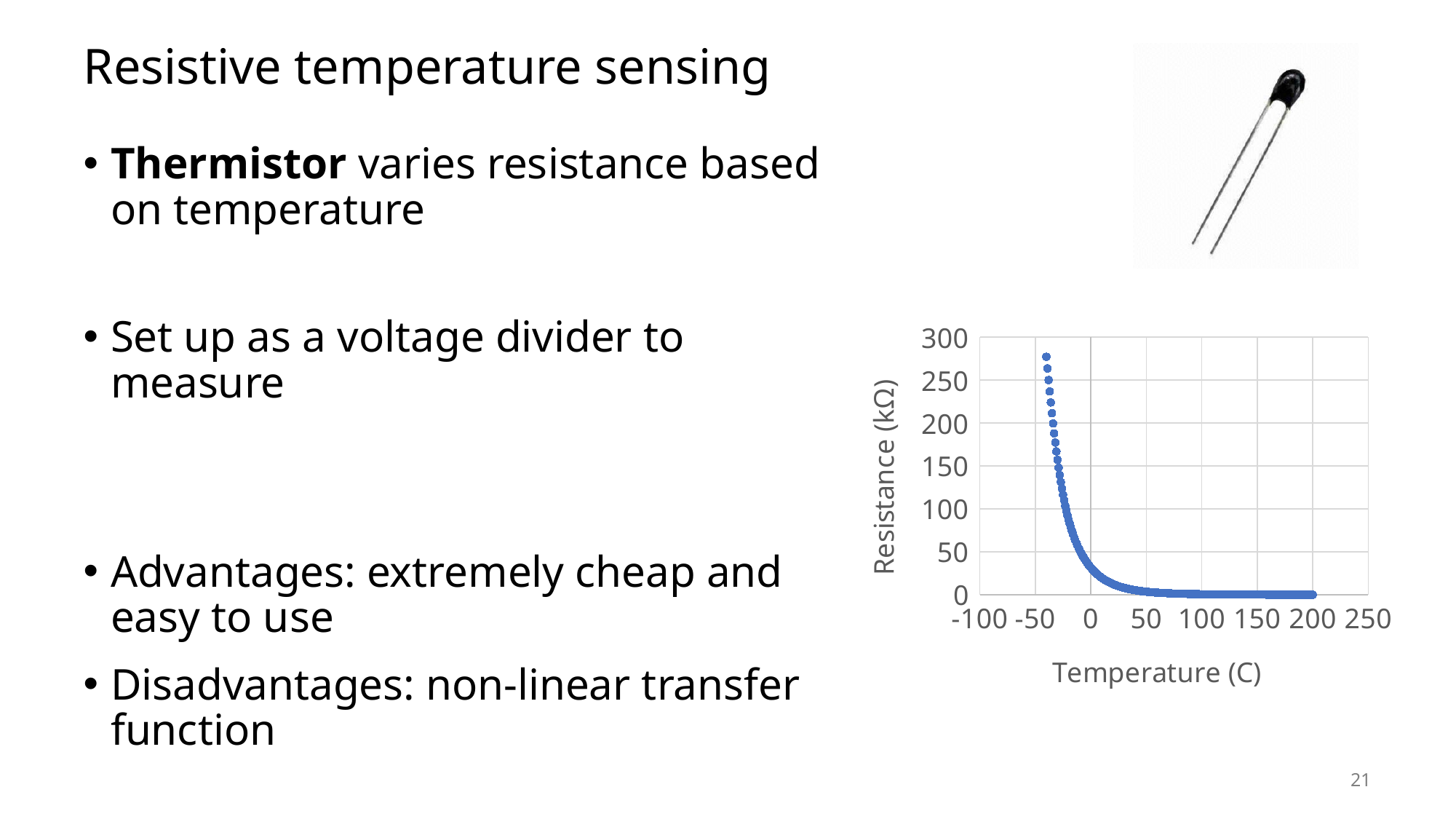
Is the resistance value at a temperature of 0 C greater or less than 100 kΩ? less Is the resistance value at a temperature of 200 C greater or less than 50 kΩ? less What is the label of the x axis of the chart? Temperature (C) Is the highest plotted resistance value greater or less than 250 kΩ? greater At which end of the temperature range is the resistance highest, the low-temperature end or the high-temperature end? low-temperature end What kind of chart is shown on the slide? scatter chart Which has the larger resistance, the point at -40 C or the point at 50 C? -40 C Does resistance rise or fall as temperature increases along the x axis? fall What is the label of the y axis of the chart? Resistance (kΩ) What is the highest tick value shown on the y axis? 300